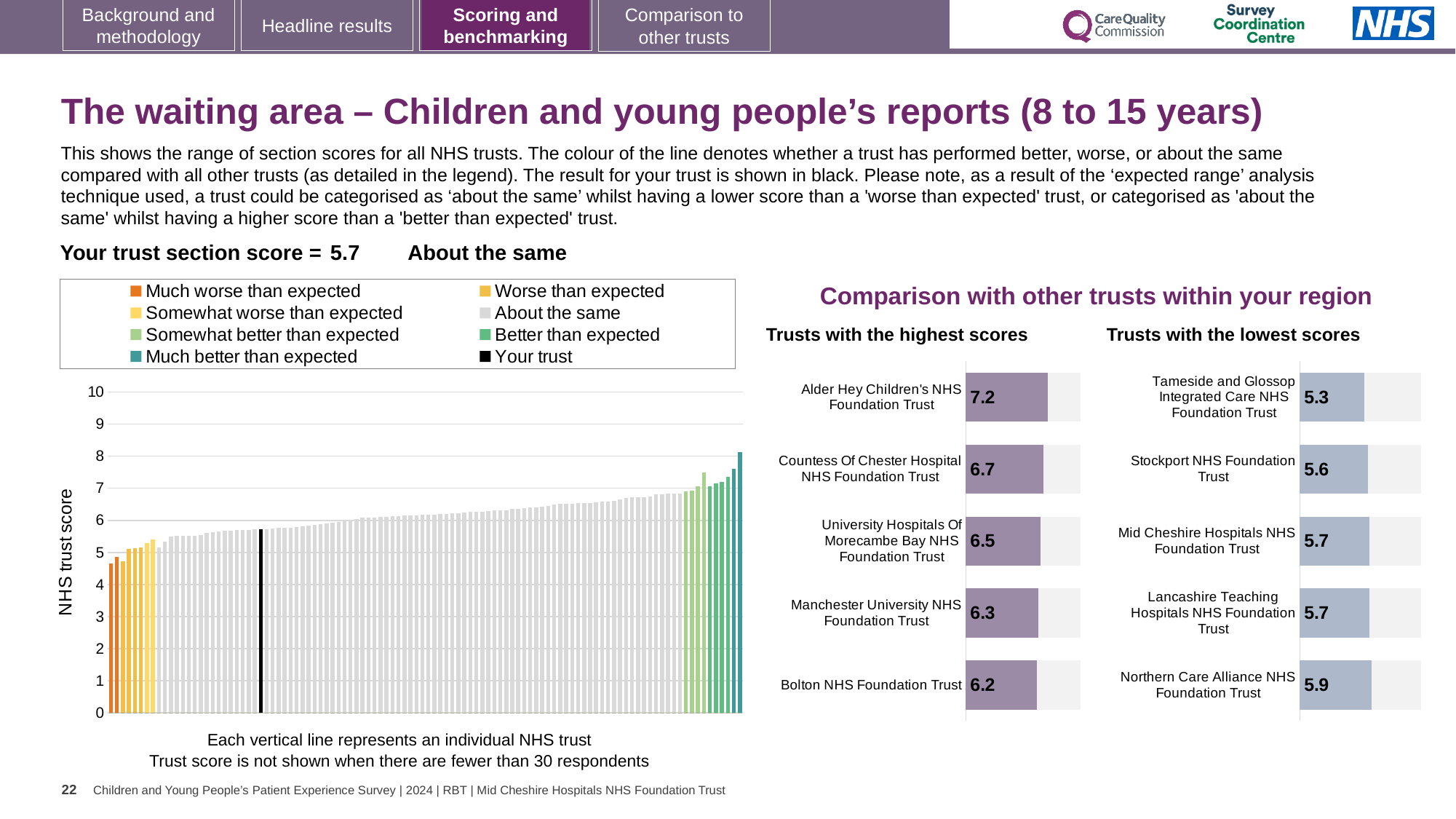
In the 'Trusts with the lowest scores' chart, what is the score for Stockport NHS Foundation Trust? 5.6 In the 'Trusts with the highest scores' chart, what is the score for Alder Hey Children's NHS Foundation Trust? 7.2 In the main chart on the left, is the value of the lowest (leftmost) bar greater or less than 5? less In the 'Trusts with the highest scores' chart, what is the difference between the scores of Alder Hey Children's NHS Foundation Trust and Bolton NHS Foundation Trust? 1.0 In the main chart on the left, what is the section score for your trust (the black bar)? 5.7 What kind of chart is the main chart on the left of the slide? bar chart How many trusts are shown in the 'Trusts with the highest scores' chart? 5 In the main chart on the left, do the bar values rise or fall from left to right? rise In the 'Trusts with the highest scores' chart, which trust has the lowest score? Bolton NHS Foundation Trust How many entries does the legend above the main chart on the left list? 8 In the 'Trusts with the lowest scores' chart, which trust has the lowest score? Tameside and Glossop Integrated Care NHS Foundation Trust In the 'Trusts with the lowest scores' chart, which has the higher score: Northern Care Alliance NHS Foundation Trust or Tameside and Glossop Integrated Care NHS Foundation Trust? Northern Care Alliance NHS Foundation Trust